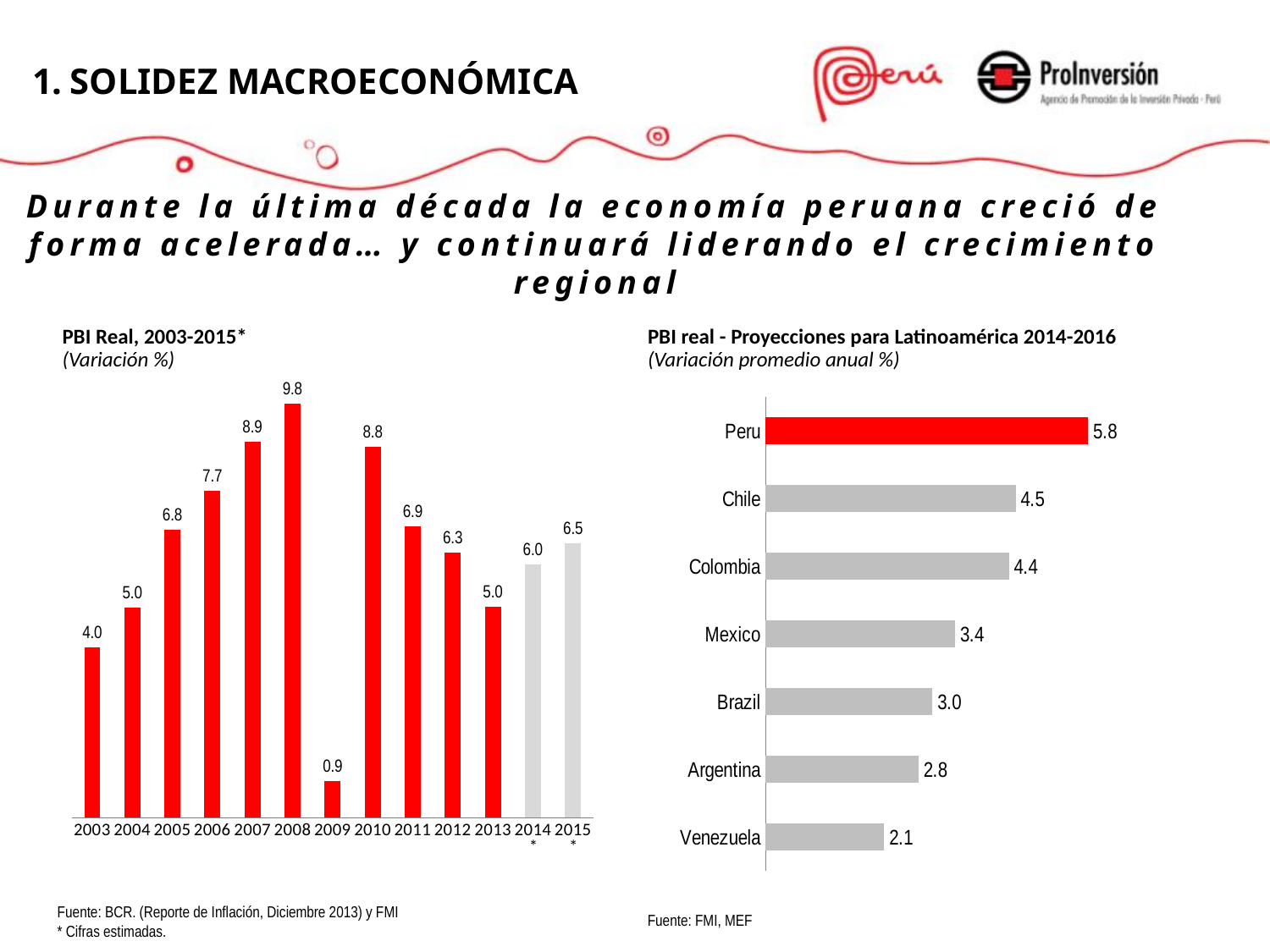
In the 'PBI Real, 2003-2015*' chart, which year has the highest value? 2008 In the 'PBI Real, 2003-2015*' chart, how many years are shown on the x axis? 13 What kind of chart is the 'PBI real - Proyecciones para Latinoamérica 2014-2016' chart? Bar chart In the 'PBI real - Proyecciones para Latinoamérica 2014-2016' chart, what is the difference between the values for Peru and Chile? 1.3 In the 'PBI real - Proyecciones para Latinoamérica 2014-2016' chart, which country has the highest value? Peru In the 'PBI Real, 2003-2015*' chart, what is the value for 2008? 9.8 In the 'PBI Real, 2003-2015*' chart, which year has the lowest value? 2009 In the 'PBI Real, 2003-2015*' chart, what is the value for 2015*? 6.5 In the 'PBI Real, 2003-2015*' chart, is the value for 2007 larger or smaller than the value for 2011? larger In the 'PBI real - Proyecciones para Latinoamérica 2014-2016' chart, what is the value for Colombia? 4.4 In the 'PBI Real, 2003-2015*' chart, what is the difference between the values for 2010 and 2009? 7.9 In the 'PBI real - Proyecciones para Latinoamérica 2014-2016' chart, which country has the lowest value? Venezuela